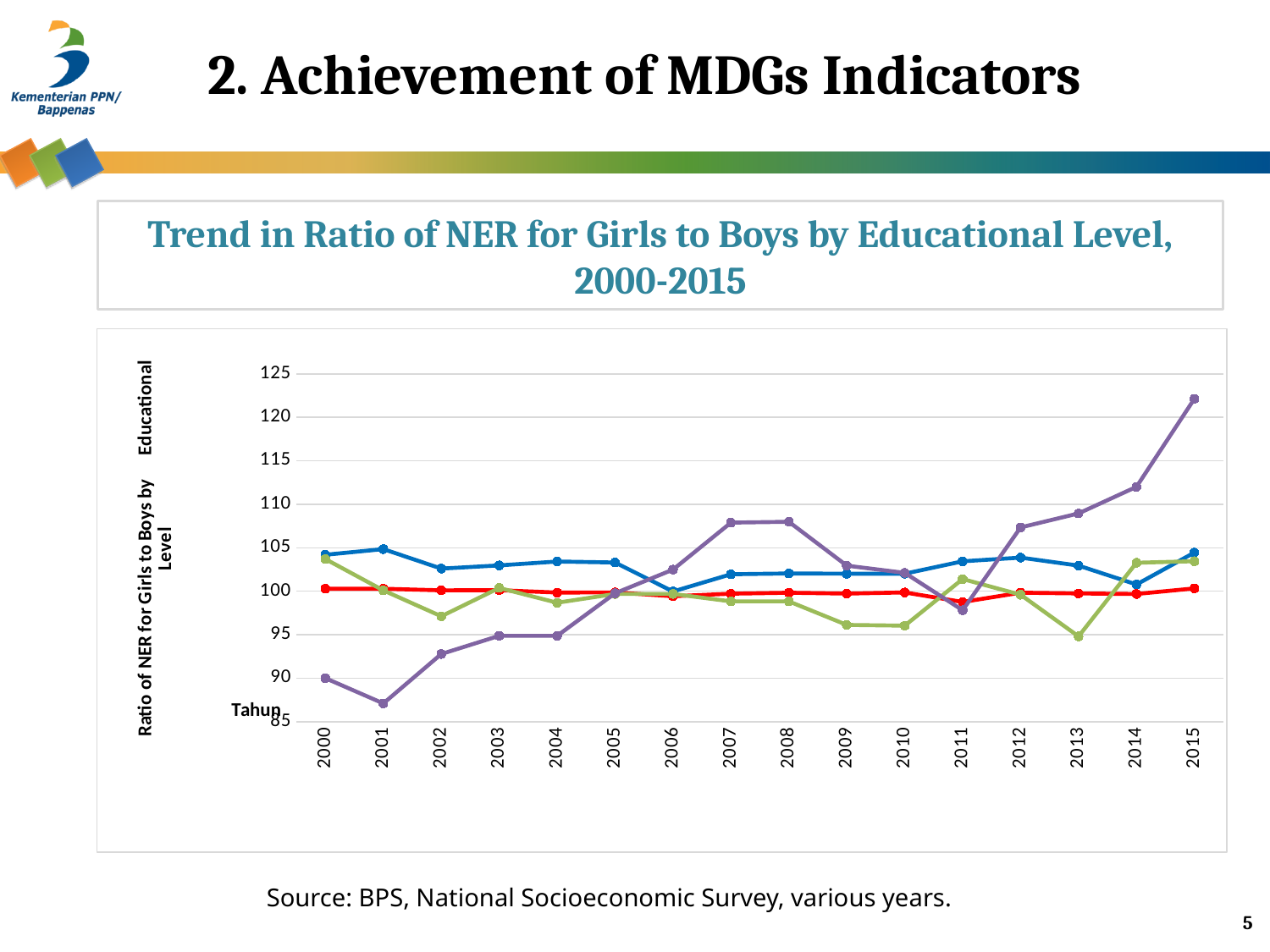
In 2015, which line has the higher value, the purple line or the blue line? purple line Is the value of the blue line in 2001 greater or less than 100? greater Does the purple line rise or fall between 2011 and 2015? rises What kind of chart is shown on the slide? line chart What is the title of the chart on the slide? Trend in Ratio of NER for Girls to Boys by Educational Level, 2000-2015 How many years are plotted along the x axis of the chart? 16 Is the value of the purple line in 2015 greater or less than 120? greater What label is shown on the x axis of the chart? Tahun In which year does the purple line reach its highest value? 2015 In which year does the purple line reach its lowest value? 2001 Is the value of the purple line in 2001 greater or less than 90? less